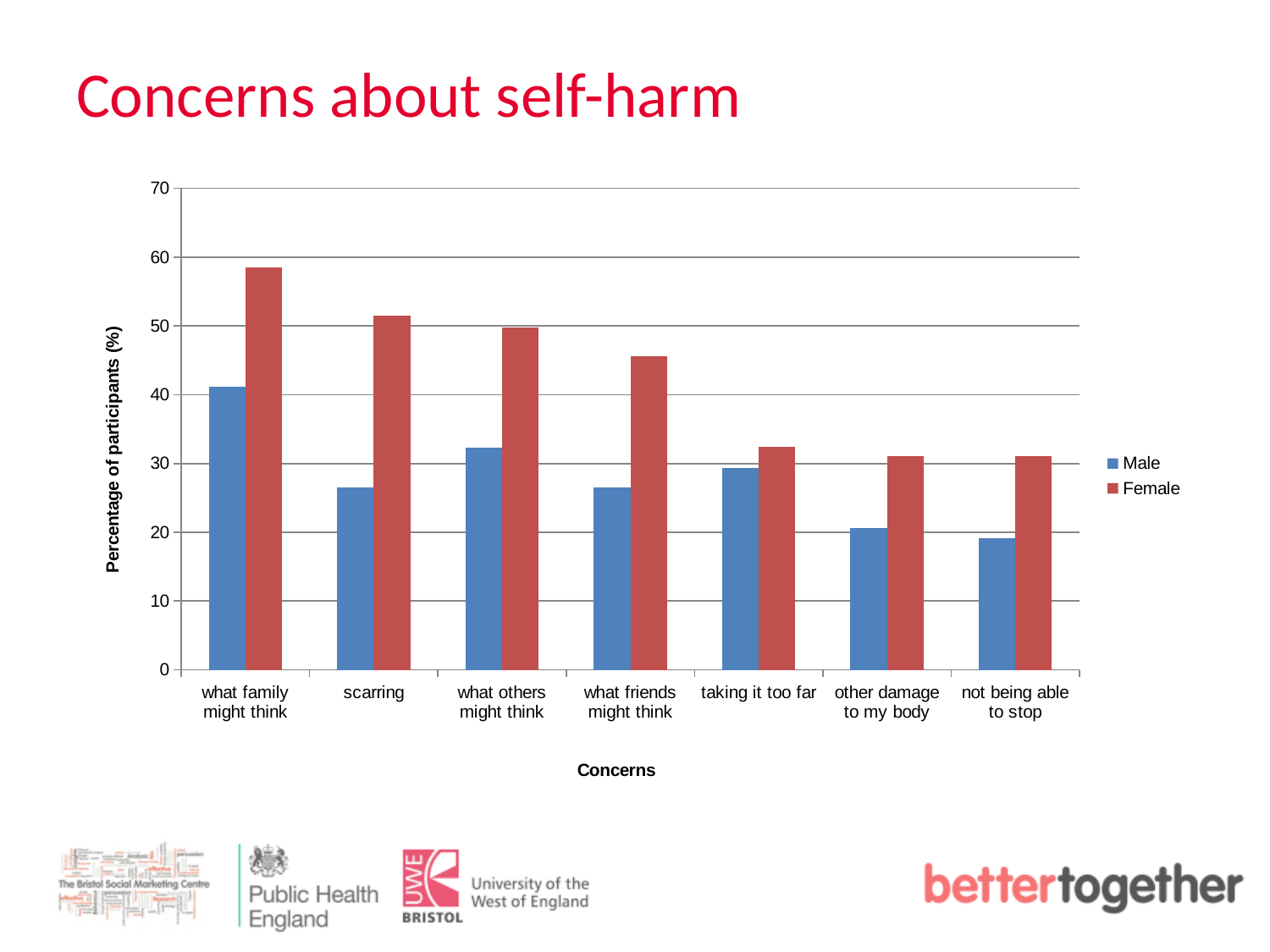
Is the Female value for 'what friends might think' greater or less than 40? greater For 'scarring', which is larger, the Male value or the Female value? Female Is the Male value for 'scarring' greater or less than 30? less Do the Female values rise or fall moving from left to right across the concerns? fall What is the title of the y axis? Percentage of participants (%) What kind of chart is shown on the slide? bar chart How many series does the legend list? 2 Is the Male value for 'what family might think' greater or less than 50? less How many concern categories are shown on the x axis? 7 Which concern has the highest Female value? what family might think Which concern has the highest Male value? what family might think